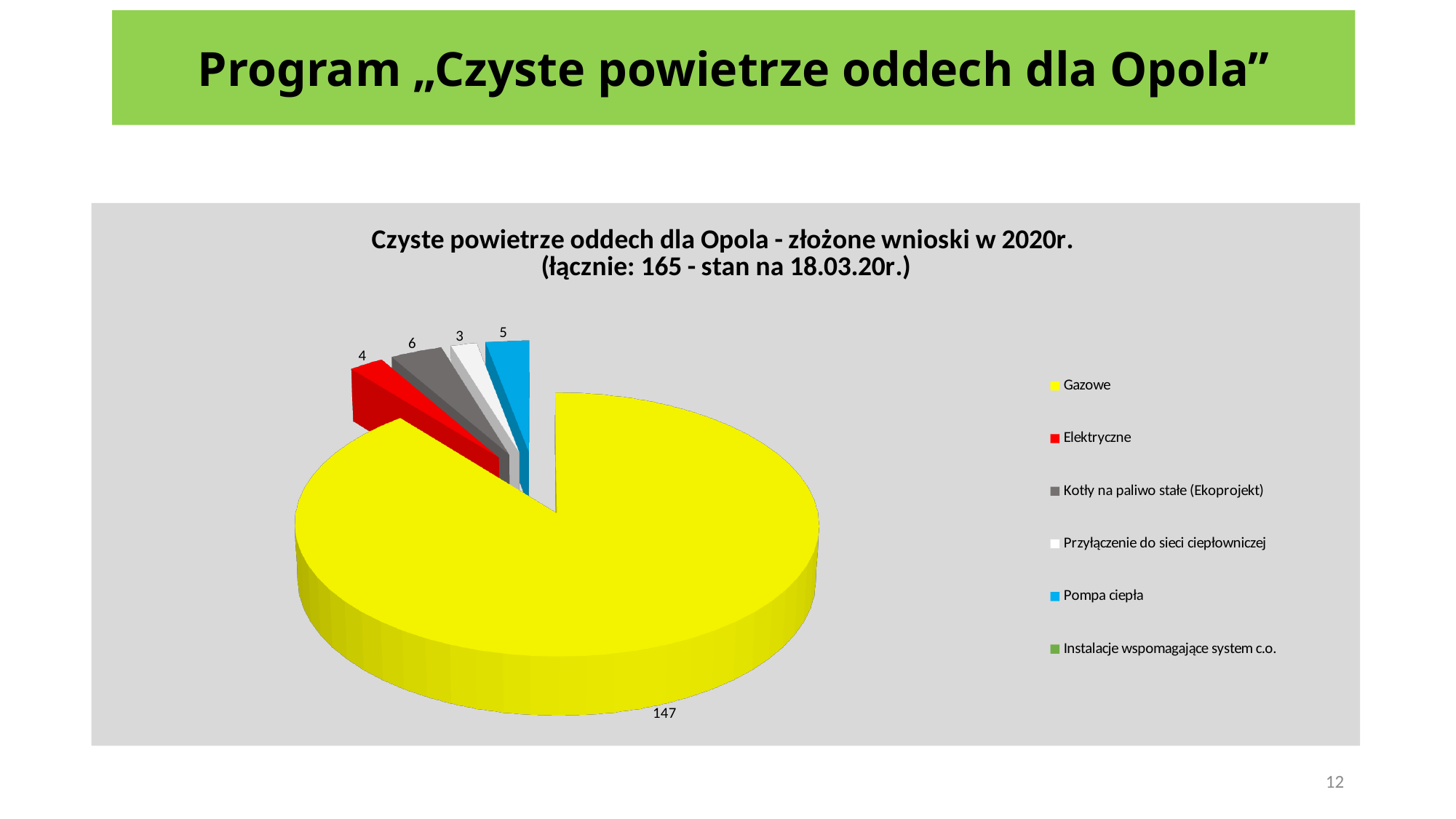
Which category has the largest slice in the pie chart? Gazowe What is the difference between the values for Gazowe and Kotły na paliwo stałe (Ekoprojekt)? 141 What is the value for Kotły na paliwo stałe (Ekoprojekt) in the pie chart? 6 What is the value for Przyłączenie do sieci ciepłowniczej in the pie chart? 3 What is the value for Elektryczne in the pie chart? 4 What total number of applications is stated in the chart title? 165 How many categories does the legend of the pie chart list? 6 Which is larger, the value for Pompa ciepła or the value for Elektryczne? Pompa ciepła What is the value for Pompa ciepła in the pie chart? 5 What is the value for Gazowe in the pie chart? 147 Which labelled slice has the smallest value in the pie chart? Przyłączenie do sieci ciepłowniczej What type of chart is shown on the slide? pie chart